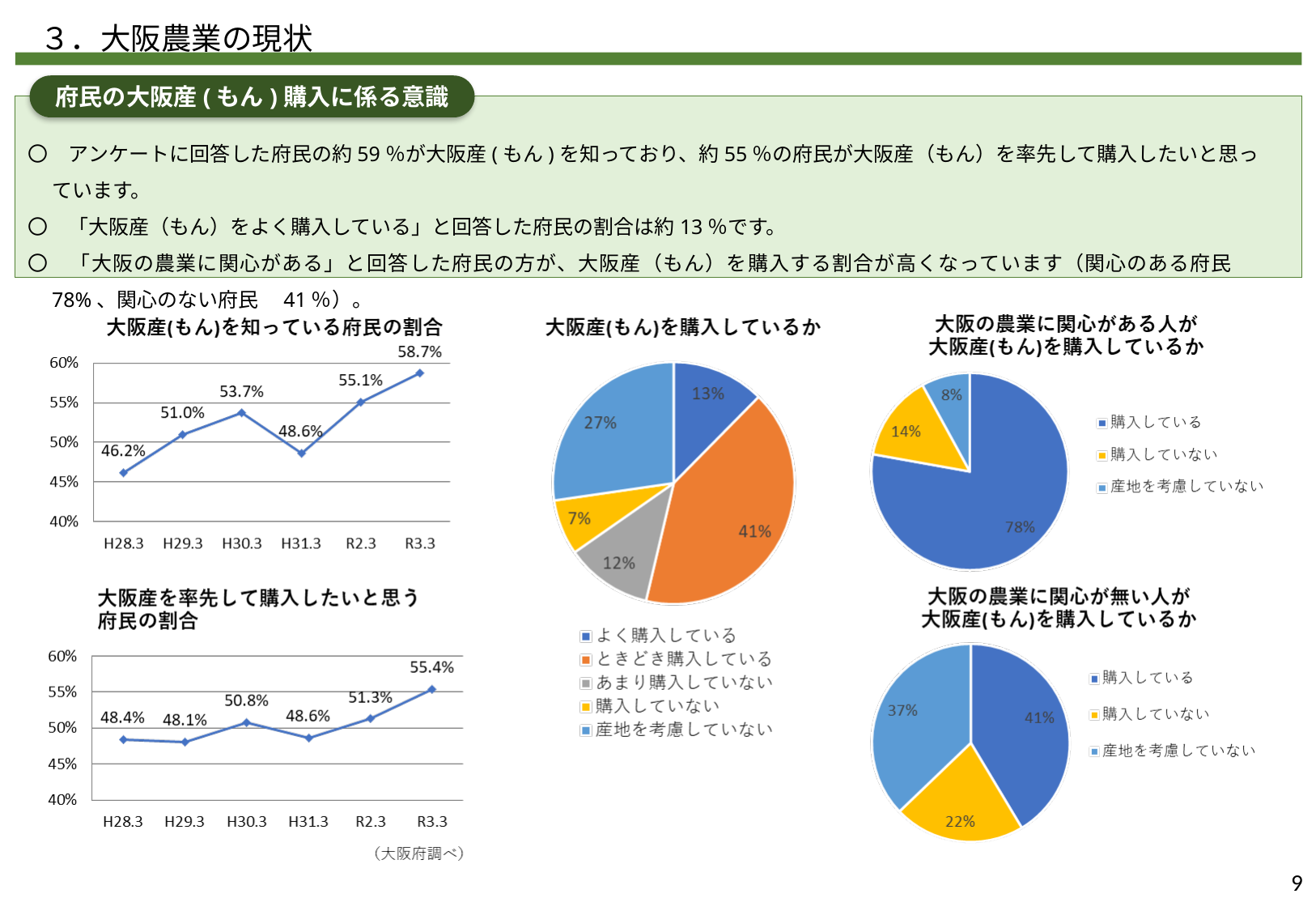
In the chart titled 大阪産を率先して購入したいと思う府民の割合, which period has the highest value? R3.3 In the pie chart titled 大阪の農業に関心が無い人が大阪産(もん)を購入しているか, which category has the smallest share? 購入していない In the chart titled 大阪産を率先して購入したいと思う府民の割合, which is larger, the value for H29.3 or the value for R2.3? R2.3 In the chart titled 大阪産(もん)を知っている府民の割合, how many data points are plotted? 6 In the pie chart titled 大阪の農業に関心がある人が大阪産(もん)を購入しているか, what share is 購入していない? 14% In the chart titled 大阪産(もん)を知っている府民の割合, what is the value for R3.3? 58.7% In the pie chart titled 大阪産(もん)を購入しているか, how many categories does the legend list? 5 In the chart titled 大阪産(もん)を知っている府民の割合, what is the difference between the values for R3.3 and H28.3? 12.5% In the pie chart titled 大阪産(もん)を購入しているか, what share is ときどき購入している? 41% What kind of chart is the one titled 大阪産を率先して購入したいと思う府民の割合? line chart In the chart titled 大阪産を率先して購入したいと思う府民の割合, what is the value for H30.3? 50.8% In the chart titled 大阪産(もん)を知っている府民の割合, which period has the lowest value? H28.3